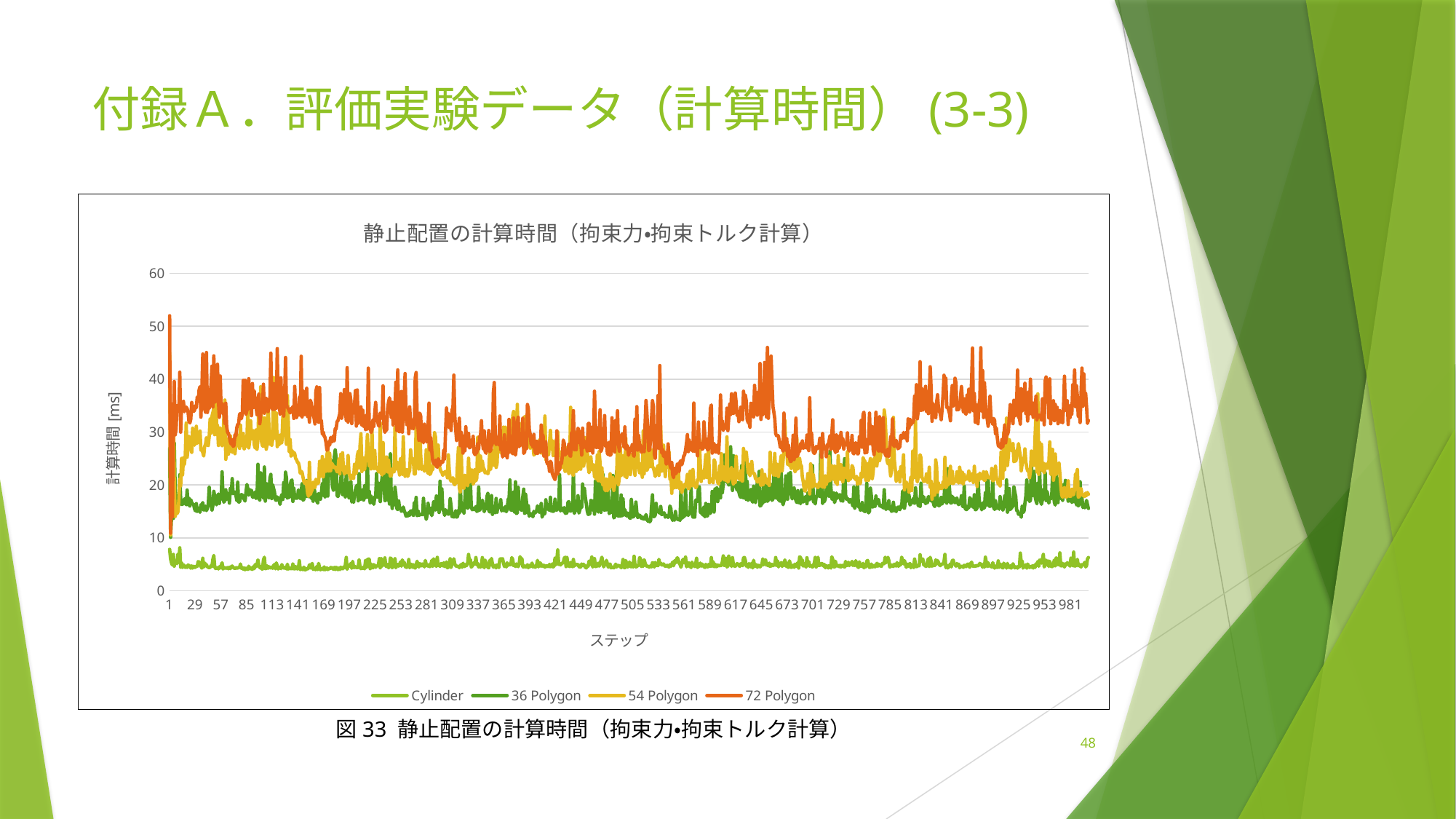
What is the maximum value shown on the vertical axis? 60 Which series has the lowest computation time across the steps? Cylinder What is the label of the vertical axis? 計算時間 [ms] Is the value for 72 Polygon at step 100 greater or less than 30? greater Which series is drawn in orange? 72 Polygon What kind of chart is shown on the slide? line chart Which series has the highest computation time across the steps? 72 Polygon How many series does the legend list? 4 Which series generally has larger values, 36 Polygon or 54 Polygon? 54 Polygon Is the value for Cylinder at step 500 greater or less than 10? less Is the value for 36 Polygon at step 300 greater or less than 30? less